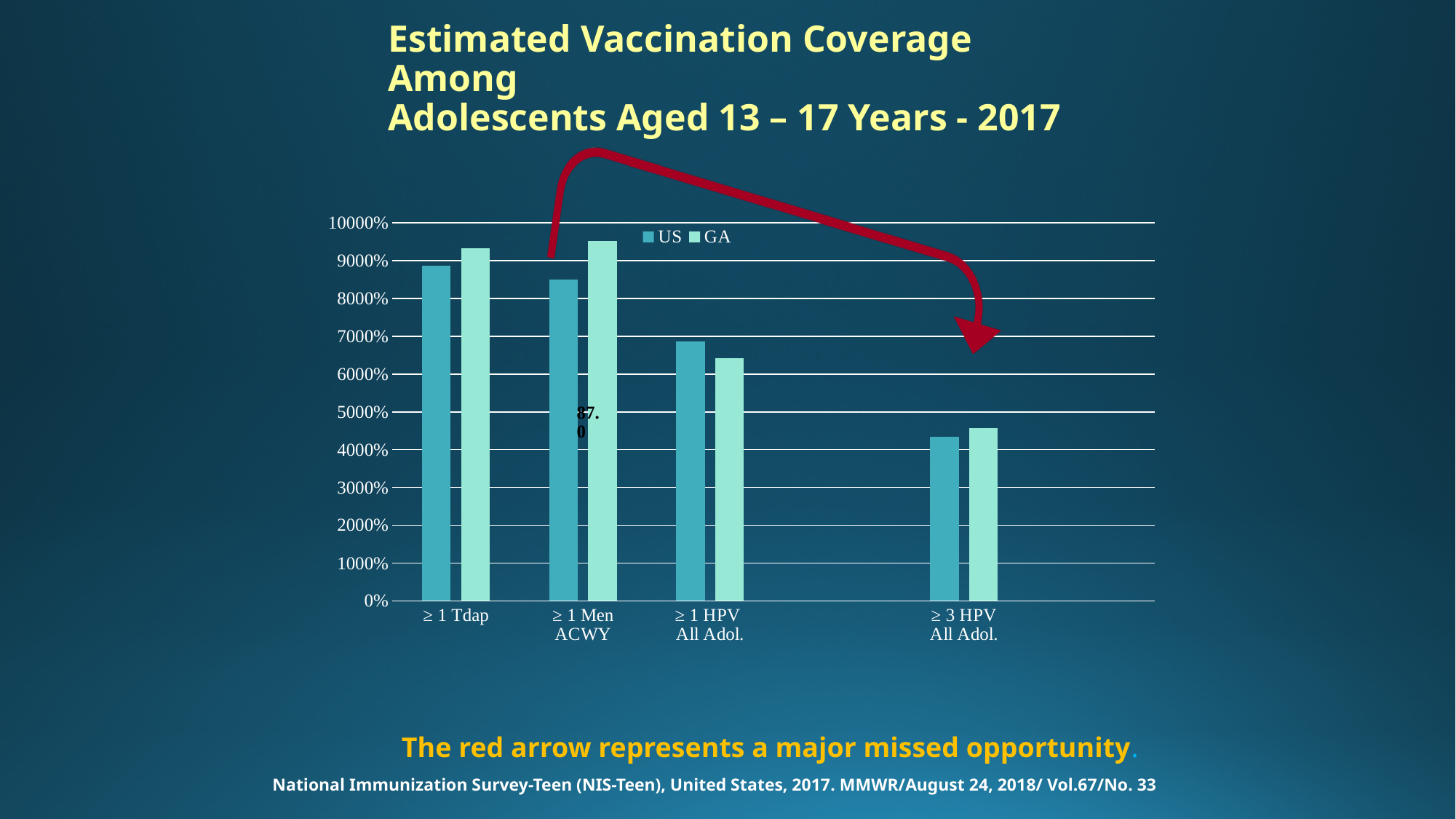
What kind of chart is shown on the slide? Bar chart For ≥ 1 HPV All Adol., which is larger, the US bar or the GA bar? US Which category has the shortest US bar? ≥ 3 HPV All Adol. Which category has the tallest GA bar? ≥ 1 Men ACWY For ≥ 1 Tdap, which is larger, the US bar or the GA bar? GA How many categories are shown on the x axis? 4 How many series does the legend list? 2 Is the US value for ≥ 1 HPV All Adol. greater or less than 7000%? less Do the US values generally rise or fall from left to right across the categories? Fall Is the GA value for ≥ 3 HPV All Adol. greater or less than 5000%? less Is the GA value for ≥ 1 Men ACWY greater or less than 9000%? greater Which series are listed in the legend? US and GA